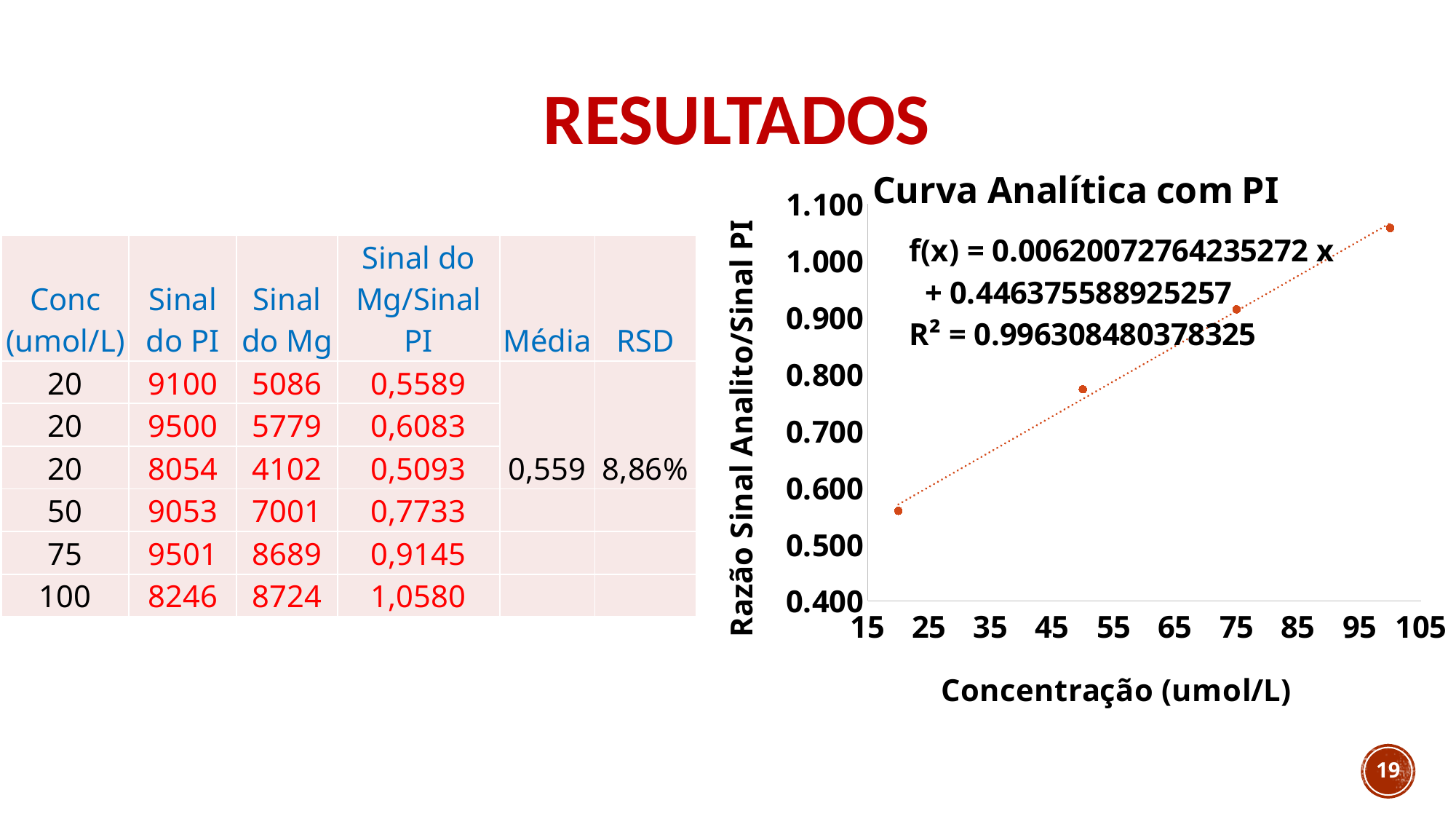
Is the plotted value at concentration 75 greater or less than 1.000? less What is the title of the chart? Curva Analítica com PI Do the plotted values rise or fall as concentration increases along the x axis? Rise At which concentration is the plotted ratio highest? 100 Is the plotted value at concentration 20 greater or less than 0.600? less What kind of chart is shown on the slide? Scatter chart Is the plotted value at concentration 50 greater or less than 0.700? greater At which concentration is the plotted ratio lowest? 20 How many data points are plotted in the chart? 4 What R² value is printed on the chart? 0.996308480378325 Which has the larger plotted ratio, concentration 50 or concentration 75? 75